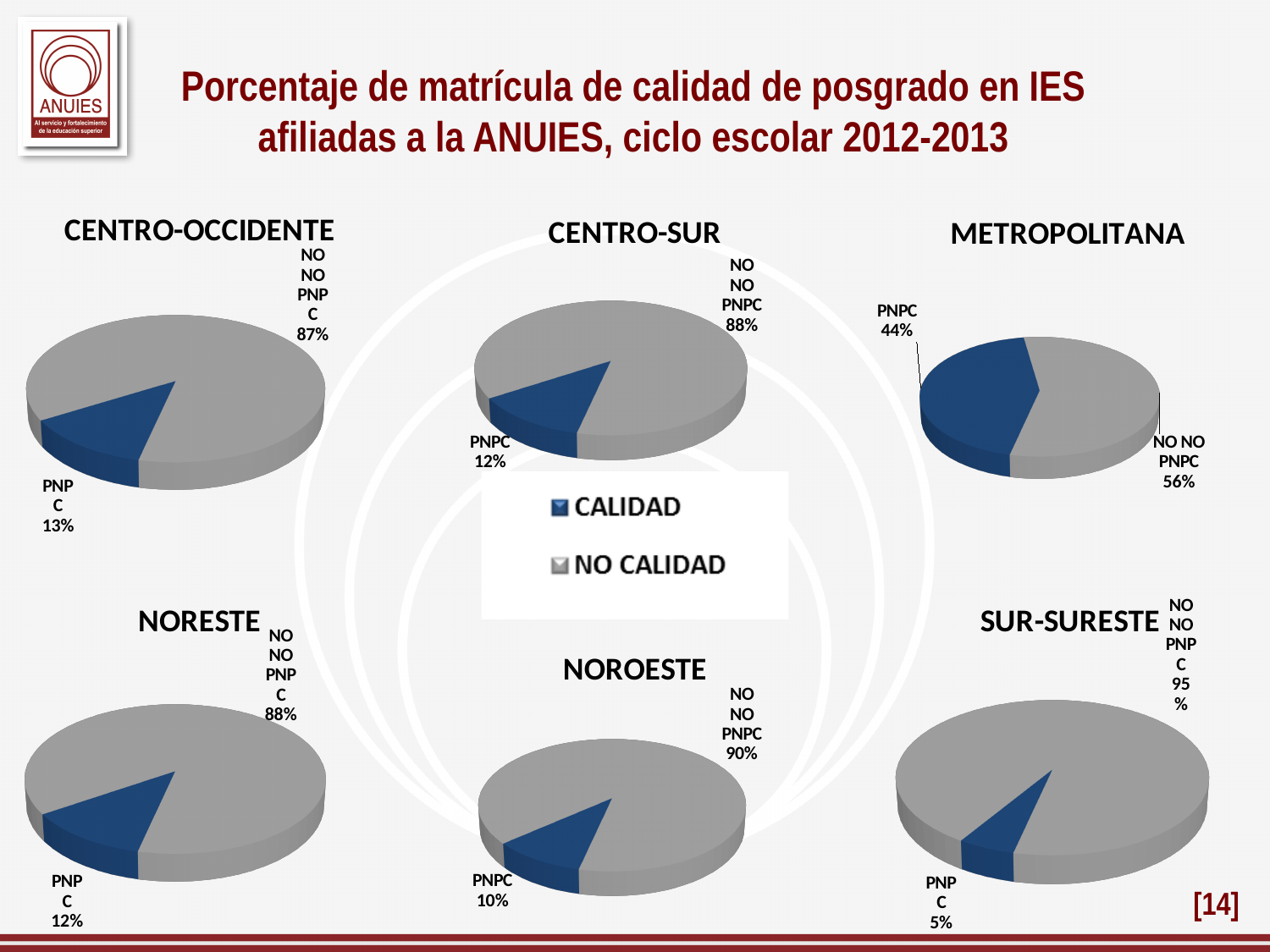
In the SUR-SURESTE chart, what is the difference between the NO NO PNPC and PNPC percentages? 90% In the CENTRO-SUR chart, what percentage is shown for the NO NO PNPC slice? 88% In the METROPOLITANA chart, what percentage is shown for the PNPC slice? 44% In the NORESTE chart, which slice is larger, PNPC or NO NO PNPC? NO NO PNPC How many entries does the shared legend list? 2 In the SUR-SURESTE chart, what percentage is shown for the NO NO PNPC slice? 95% What kind of chart is used for each region on this slide? Pie chart In the CENTRO-OCCIDENTE chart, what percentage is shown for the PNPC slice? 13% How many pie charts are shown on the slide? 6 Which region's chart has the largest PNPC share? METROPOLITANA In the NOROESTE chart, what percentage is shown for the PNPC slice? 10% In the METROPOLITANA chart, what is the difference between the NO NO PNPC and PNPC percentages? 12%